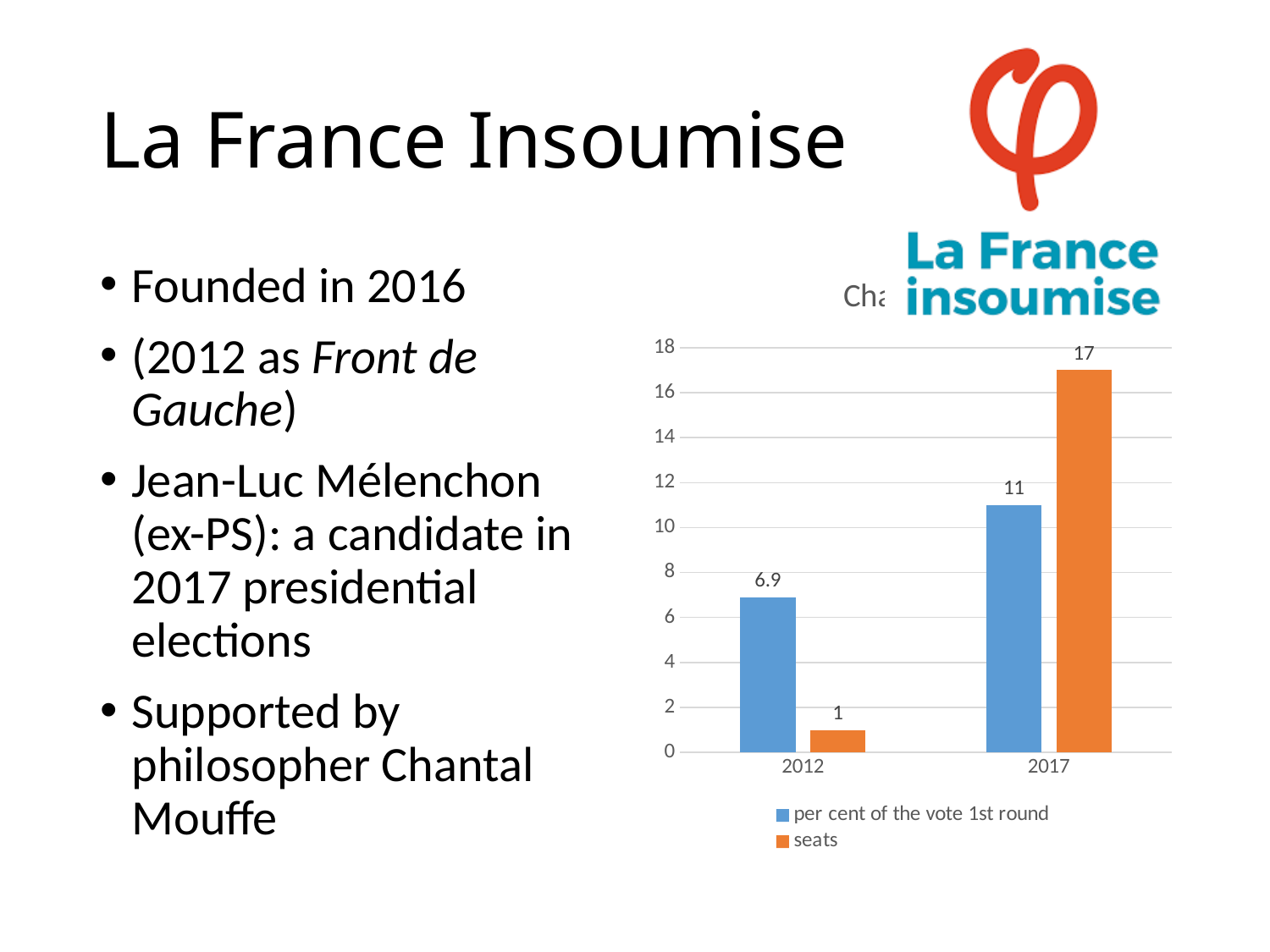
How many seats are shown for 2017? 17 In 2017, which is larger: the per cent of the vote 1st round or the number of seats? seats Which year has the higher number of seats? 2017 Which colour represents the seats series? orange What is the per cent of the vote 1st round value for 2012? 6.9 How many seats are shown for 2012? 1 Which year has the lowest per cent of the vote 1st round? 2012 What kind of chart is shown on the slide? bar chart What is the per cent of the vote 1st round value for 2017? 11 What is the difference in seats between 2017 and 2012? 16 How many series does the legend list? 2 What is the difference in per cent of the vote 1st round between 2017 and 2012? 4.1